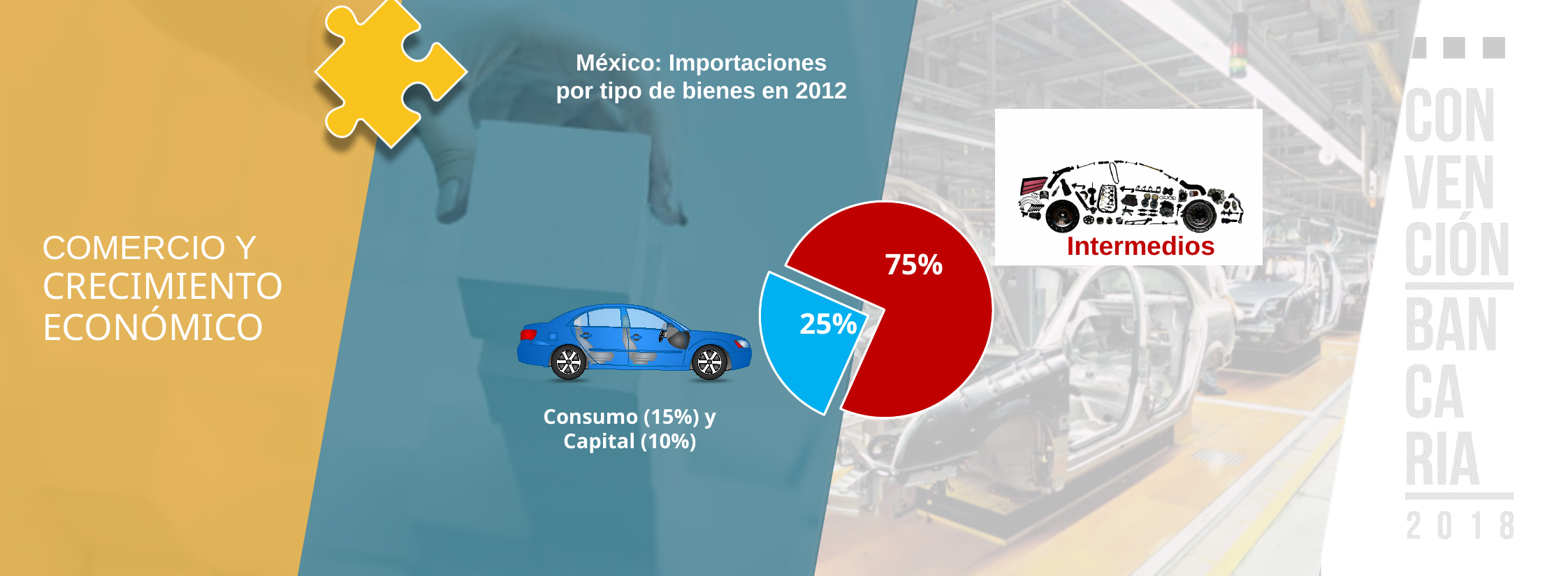
What share of the pie does the Intermedios slice represent? 75% What is the difference in percentage points between the Intermedios slice and the Consumo y Capital slice? 50 percentage points Which slice of the pie is the largest? Intermedios How many slices does the pie chart have? 2 What percentage is attributed to Consumo within the 25% slice? 15% What percentage is attributed to Capital within the 25% slice? 10% What colour is the Intermedios slice of the pie? Red Which is larger, the Intermedios slice or the Consumo y Capital slice? Intermedios What share of the pie does the Consumo y Capital slice represent? 25% What is the title of the chart? México: Importaciones por tipo de bienes en 2012 Which slice of the pie is the smallest? Consumo y Capital What kind of chart is shown on the slide? Pie chart